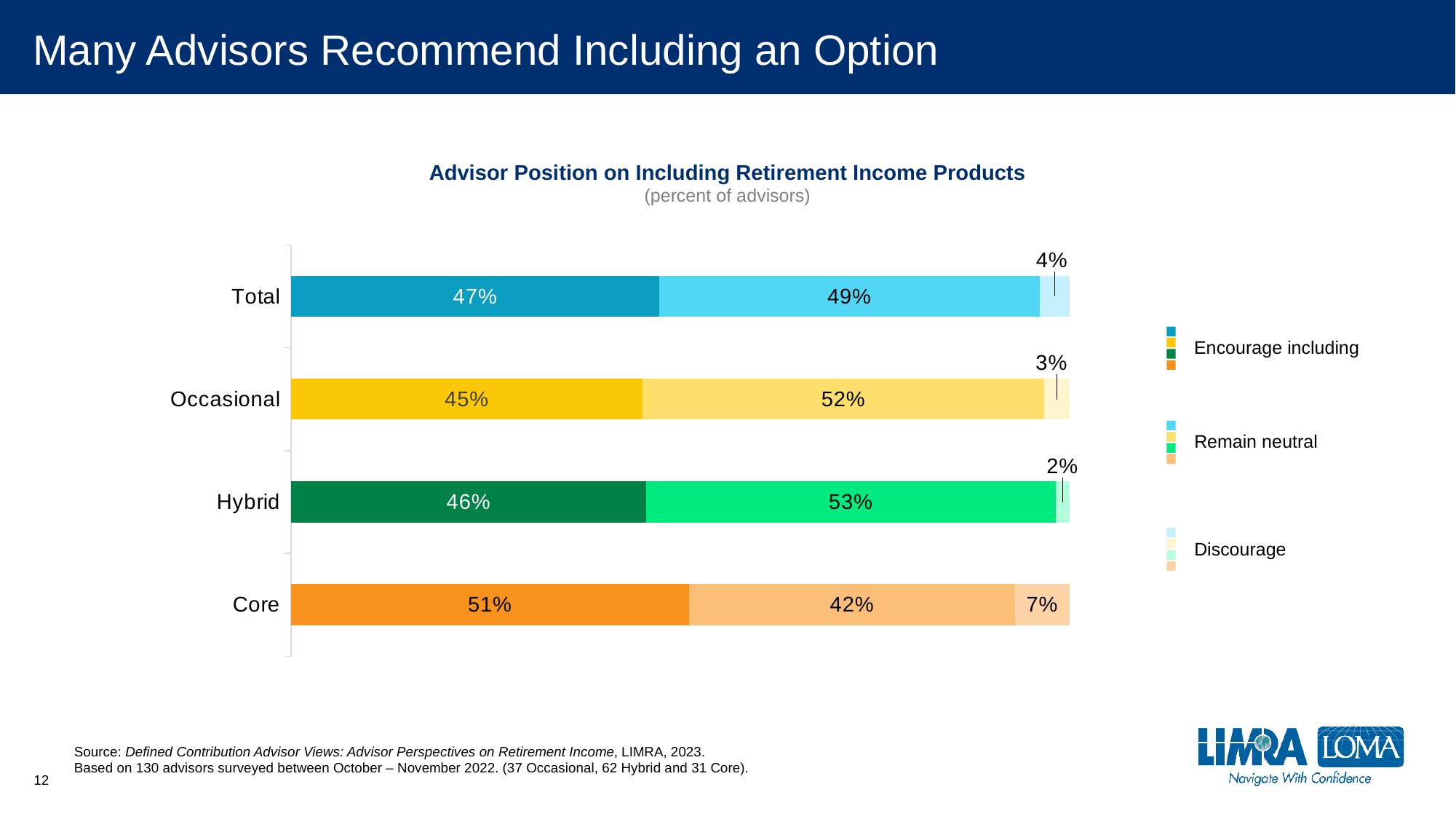
How many advisor groups are shown on the chart? 4 What kind of chart is shown on the slide? Stacked bar chart What is the title of the chart? Advisor Position on Including Retirement Income Products Which advisor group has the lowest share that discourage? Hybrid What percentage of Hybrid advisors remain neutral? 53% Is the 'Encourage including' share larger for Core or for Occasional? Core What percentage of Core advisors encourage including retirement income products? 51% What is the difference between the 'Remain neutral' share for Hybrid and for Core? 11% Which advisor group has the highest share that encourage including? Core What percentage of Occasional advisors discourage including retirement income products? 3% What is the Total value for 'Remain neutral'? 49% How many series does the legend list? 3